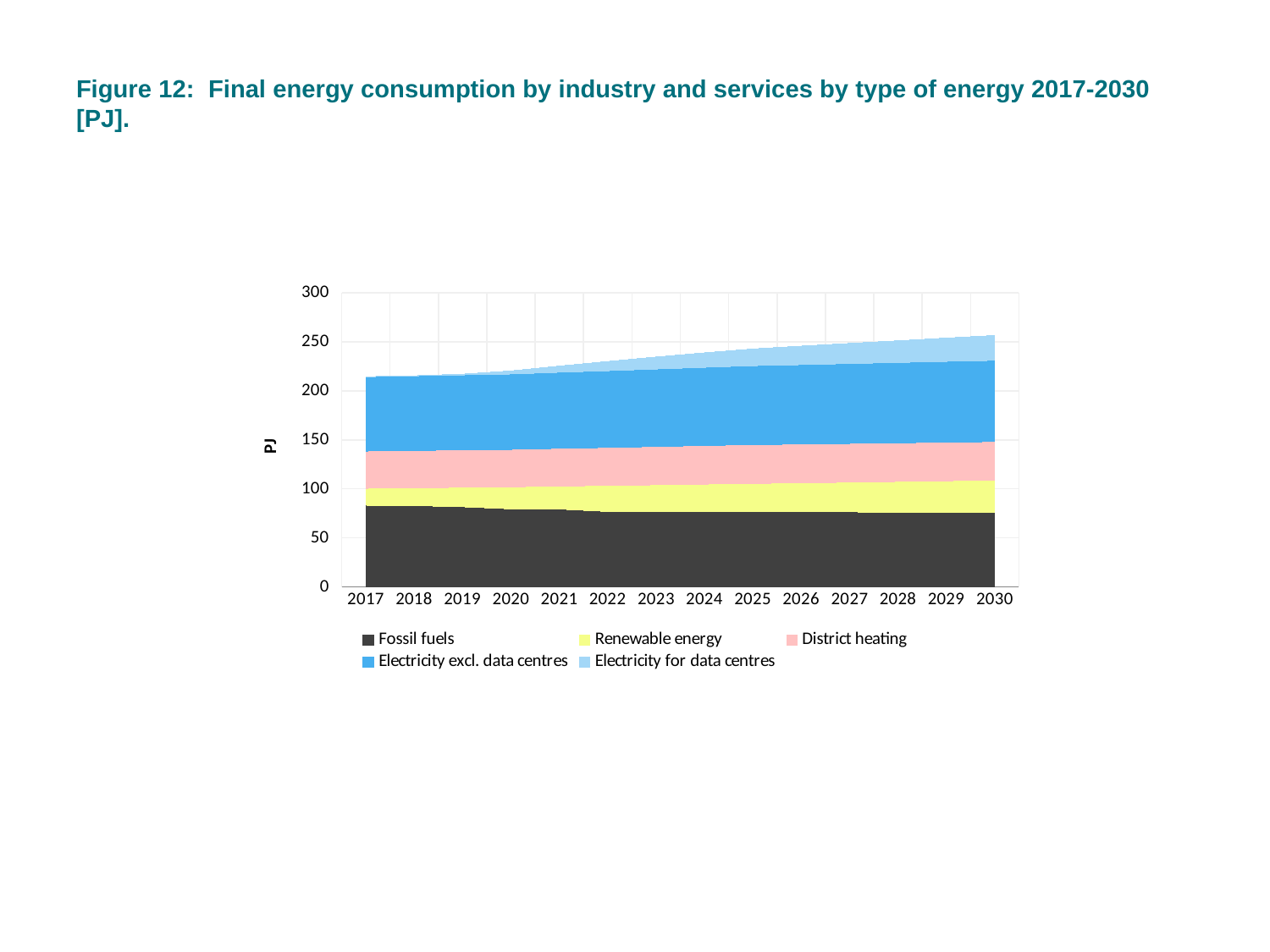
Does the total final energy consumption rise or fall from 2017 to 2030? Rise Is the value for Fossil fuels in 2030 greater or less than 50? greater What is the figure number given in the chart title? Figure 12 Is the total consumption in 2017 greater or less than 200 PJ? greater Does the Electricity for data centres band rise or fall from 2017 to 2030? Rise Does the Fossil fuels band rise or fall from 2017 to 2030? Fall Which series contributes the smallest amount in 2017? Electricity for data centres Is the value for Fossil fuels in 2017 greater or less than 100? less What is the label on the y axis? PJ How many years are shown along the x axis? 14 What kind of chart is shown on the slide? Stacked area chart How many series does the legend list? 5